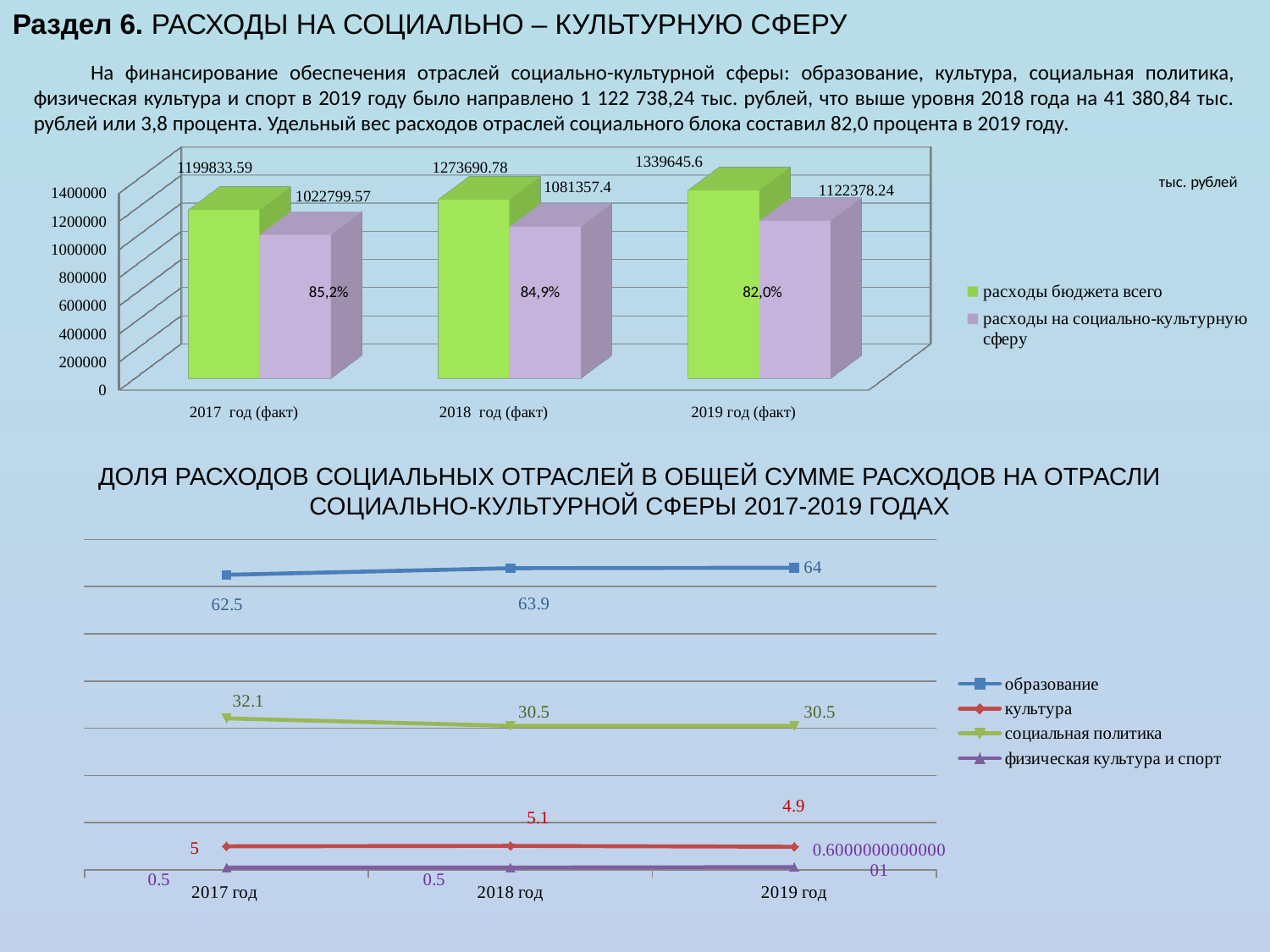
In the top bar chart, what percentage label is shown for 2018 год (факт)? 84,9% How many series does the legend of the bottom line chart list? 4 In the top bar chart, what is the value of расходы на социально-культурную сферу for 2017 год (факт)? 1022799.57 In the bottom line chart, what is the value of социальная политика for 2017 год? 32.1 In the bottom line chart, what is the value of образование for 2018 год? 63.9 In the bottom line chart, which series has the lowest values across all years? физическая культура и спорт What type of chart is the top chart on the slide? bar chart In the top bar chart, which year has the highest value for расходы бюджета всего? 2019 год (факт) How many series does the legend of the top bar chart list? 2 In the top bar chart, what is the value of расходы бюджета всего for 2019 год (факт)? 1339645.6 In the top bar chart, what is the difference between расходы бюджета всего and расходы на социально-культурную сферу in 2018 год (факт)? 192333.38 In the bottom line chart, does the value of образование rise or fall from 2017 год to 2019 год? rise